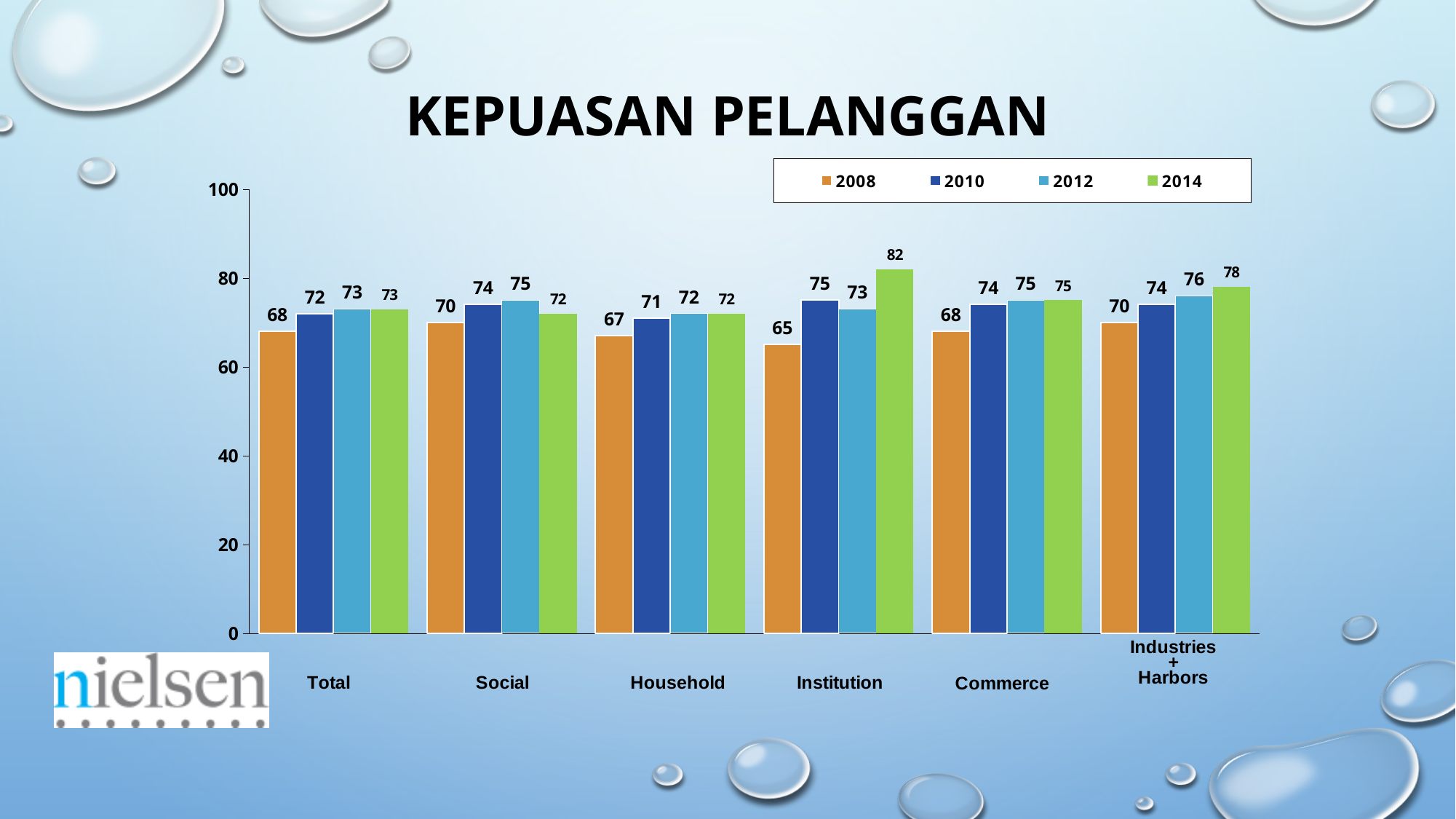
What is the value for Industries + Harbors in 2012? 76 What is the title of the chart? KEPUASAN PELANGGAN Is the value for Commerce in 2008 greater or less than 60? greater How many series does the legend list? 4 How many categories are shown on the x axis? 6 Which category has the lowest value in 2008? Institution What is the difference between the 2014 and 2008 values for Institution? 17 What is the value for Total in 2008? 68 Which category has the highest value in 2014? Institution Which is larger for Household: the 2010 value or the 2012 value? 2012 What kind of chart is shown on the slide? bar chart What is the value for Institution in 2014? 82